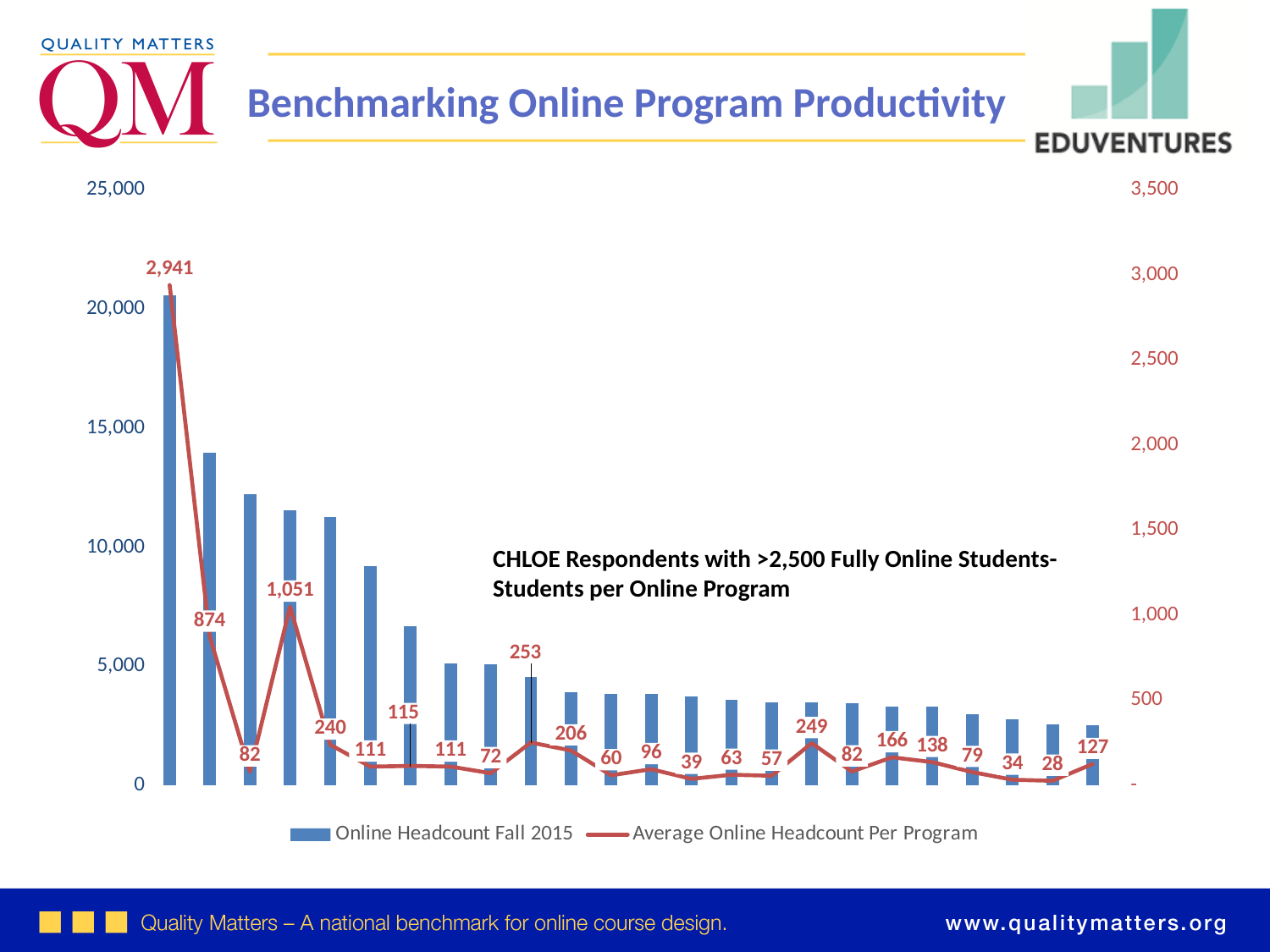
Is the Online Headcount Fall 2015 value for the third bar from the left greater or less than 10,000? greater Which is larger: the Average Online Headcount Per Program value of 1,051 at the fourth institution or 874 at the second institution? 1,051 How many series does the legend list? 2 What is the lowest value shown for the Average Online Headcount Per Program line? 28 What kind of chart is shown on the slide? Combination bar and line chart Do the Online Headcount Fall 2015 bars generally rise or fall from left to right? Fall What is the difference between the first two Average Online Headcount Per Program values, 2,941 and 874? 2,067 What is the Average Online Headcount Per Program value for the second institution from the left? 874 Is the Online Headcount Fall 2015 value for the second bar from the left greater or less than 15,000? less What is the highest value shown for the Average Online Headcount Per Program line? 2,941 How many institutions (bars) are plotted in the chart? 24 What is the Average Online Headcount Per Program value for the last (rightmost) institution? 127